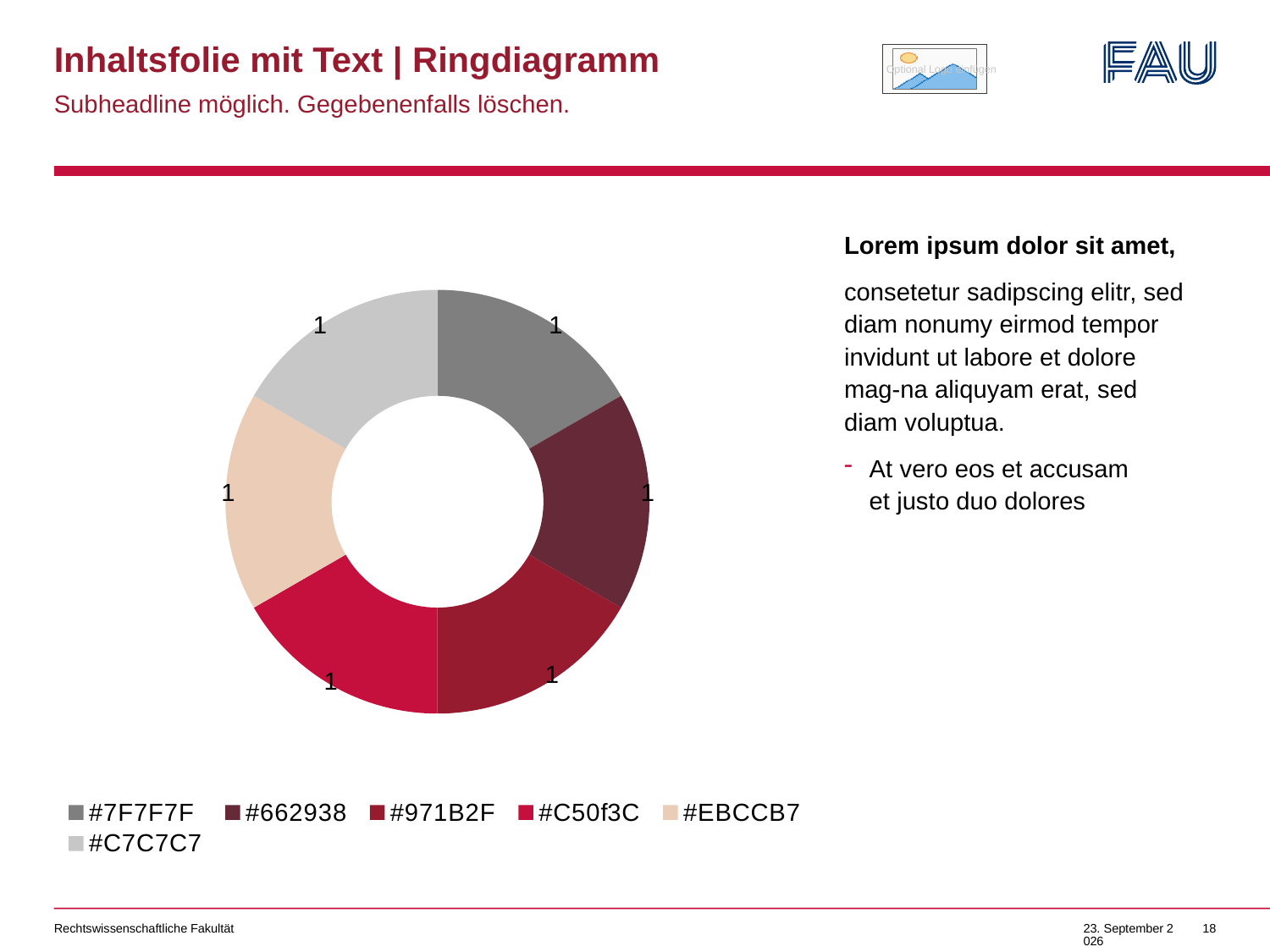
What is the value of the #EBCCB7 segment? 1 What is the value of the #C50f3C segment? 1 How many entries does the legend list? 6 What is the value of the #7F7F7F segment? 1 What is the value of the #662938 segment? 1 What is the total of all segment values in the doughnut chart? 6 What kind of chart is shown on the slide? Doughnut chart How many segments does the doughnut chart have? 6 Which legend entry is listed last? #C7C7C7 Which legend entry is listed first? #7F7F7F